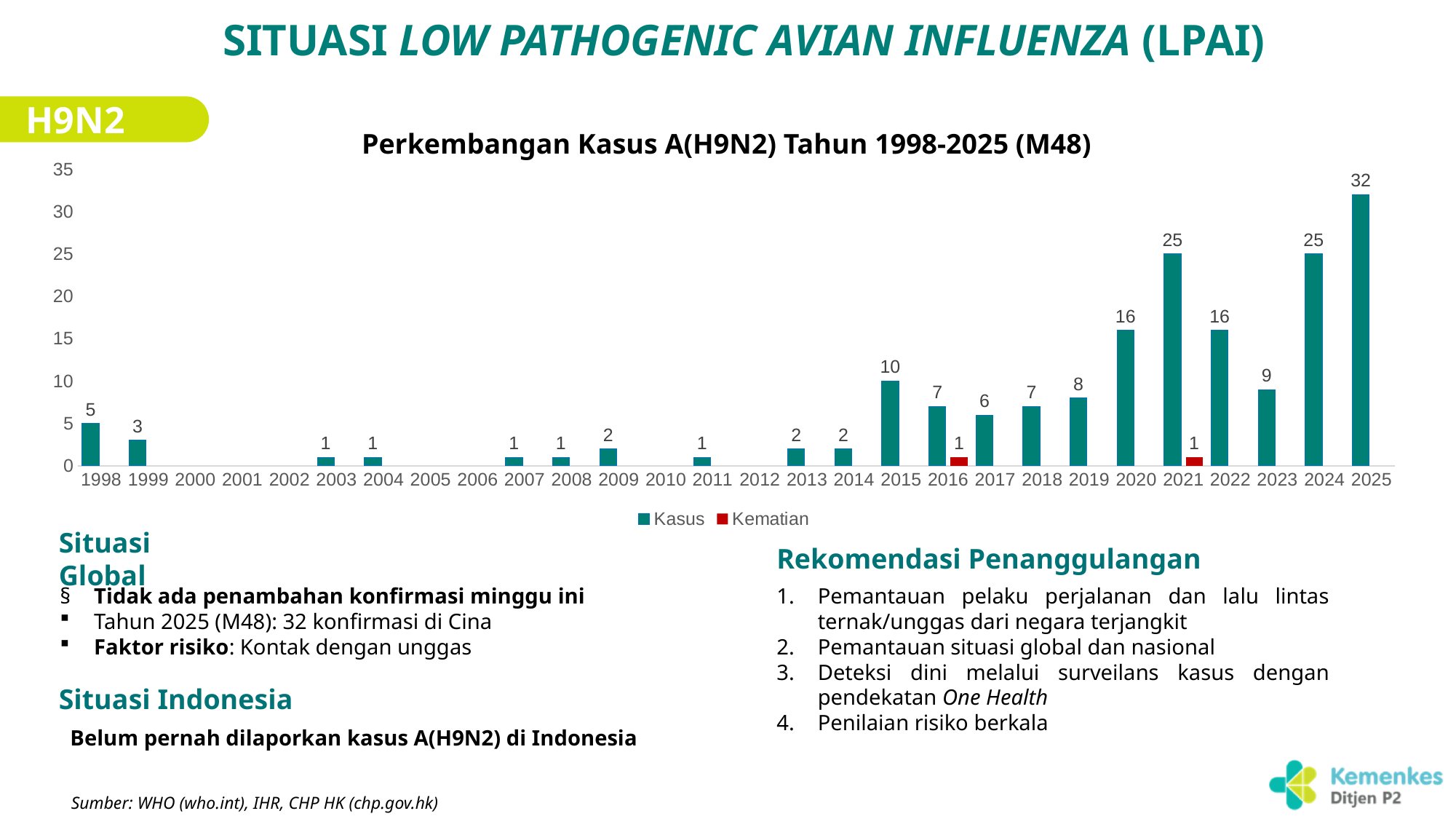
What is the title of the chart? Perkembangan Kasus A(H9N2) Tahun 1998-2025 (M48) Do the Kasus values generally rise or fall from 2013 to 2025? Rise What kind of chart is shown on the slide? Bar chart Is the value of Kasus for 2021 greater or less than 20? greater What is the value of Kematian for 2021? 1 How many series does the legend list? 2 What is the difference in Kasus between 2025 and 2024? 7 How many years are shown on the x axis of the chart? 28 Which year has the highest number of Kasus? 2025 Which year has more Kasus, 2020 or 2023? 2020 What is the value of Kasus for 2015? 10 What is the value of Kasus for 2025? 32